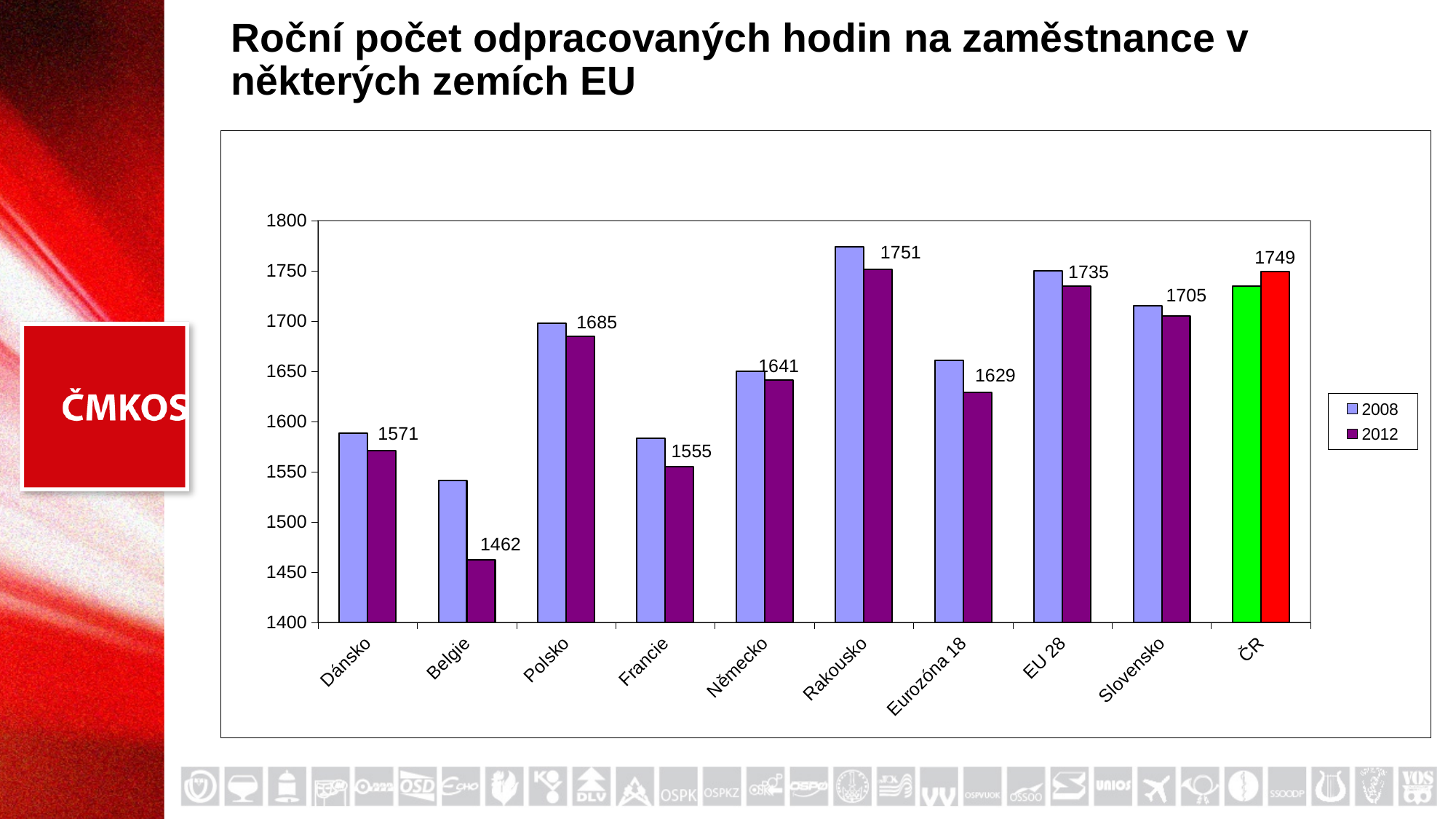
Which country has the lowest 2012 value? Belgie What is the 2012 value for Rakousko? 1751 What is the 2012 value for Belgie? 1462 Which category has the highest 2012 value? Rakousko How many countries or regions are shown on the x axis? 10 Is the 2008 value for Slovensko greater or less than 1700? greater What is the 2012 value for EU 28? 1735 Is the 2008 value for Rakousko greater or less than 1750? greater What is the difference between the 2012 values for Rakousko and Belgie? 289 How many series does the legend list? 2 Which is larger, the 2012 value for Dánsko or the 2012 value for Francie? Dánsko What kind of chart is shown on the slide? bar chart